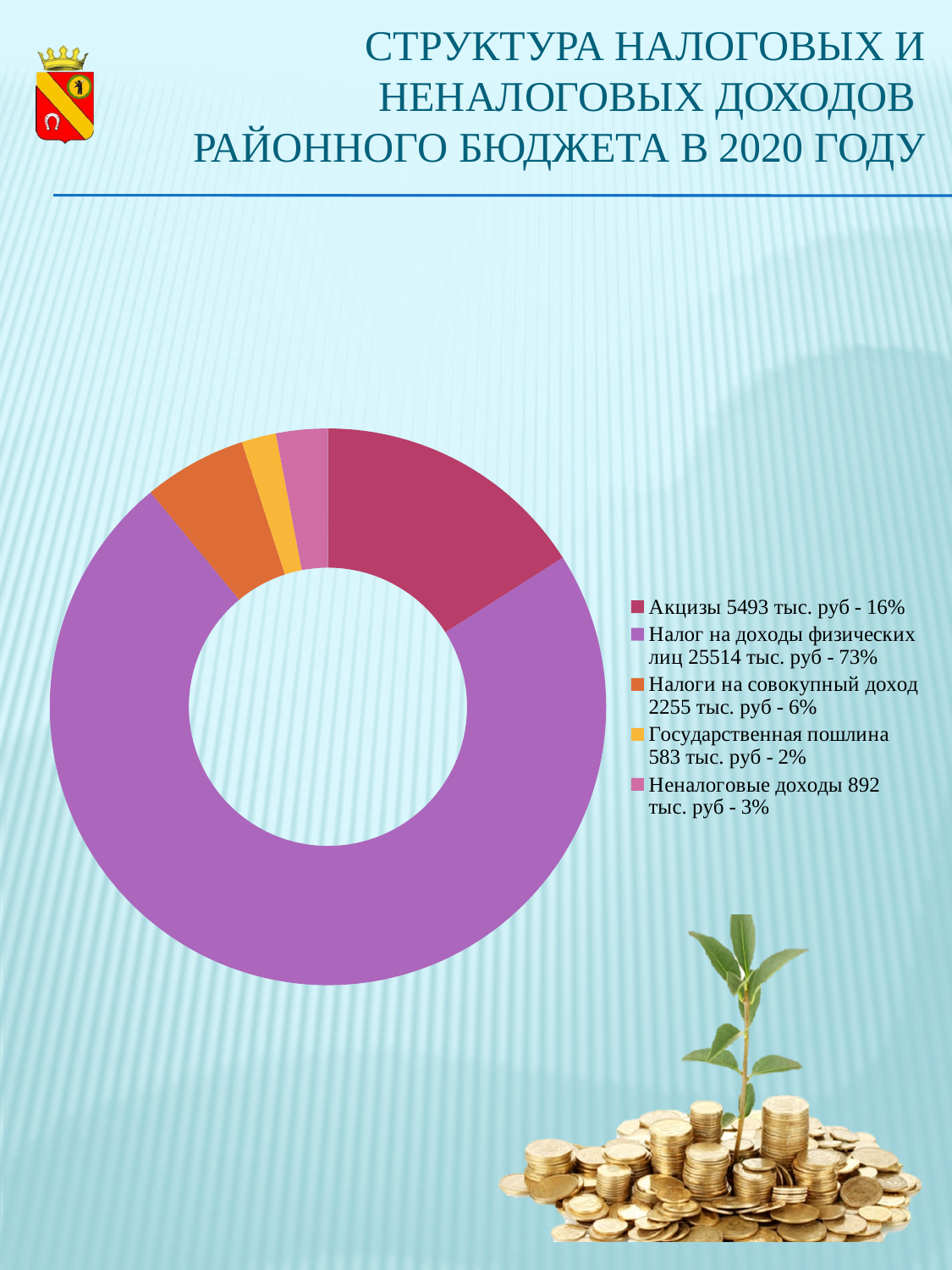
What kind of chart is shown on the slide? Doughnut (pie) chart What is the value for Государственная пошлина? 583 тыс. руб What is the difference between the values for Акцизы and Налоги на совокупный доход? 3238 тыс. руб What share of the chart does Неналоговые доходы represent? 3% Which category has the largest share? Налог на доходы физических лиц What is the value for Акцизы? 5493 тыс. руб What share of the chart does Налоги на совокупный доход represent? 6% What is the title of the slide containing the chart? Структура налоговых и неналоговых доходов районного бюджета в 2020 году Which category has the smallest share? Государственная пошлина How many categories does the chart show? 5 What is the value for Налог на доходы физических лиц? 25514 тыс. руб Which is larger, Акцизы or Налоги на совокупный доход? Акцизы